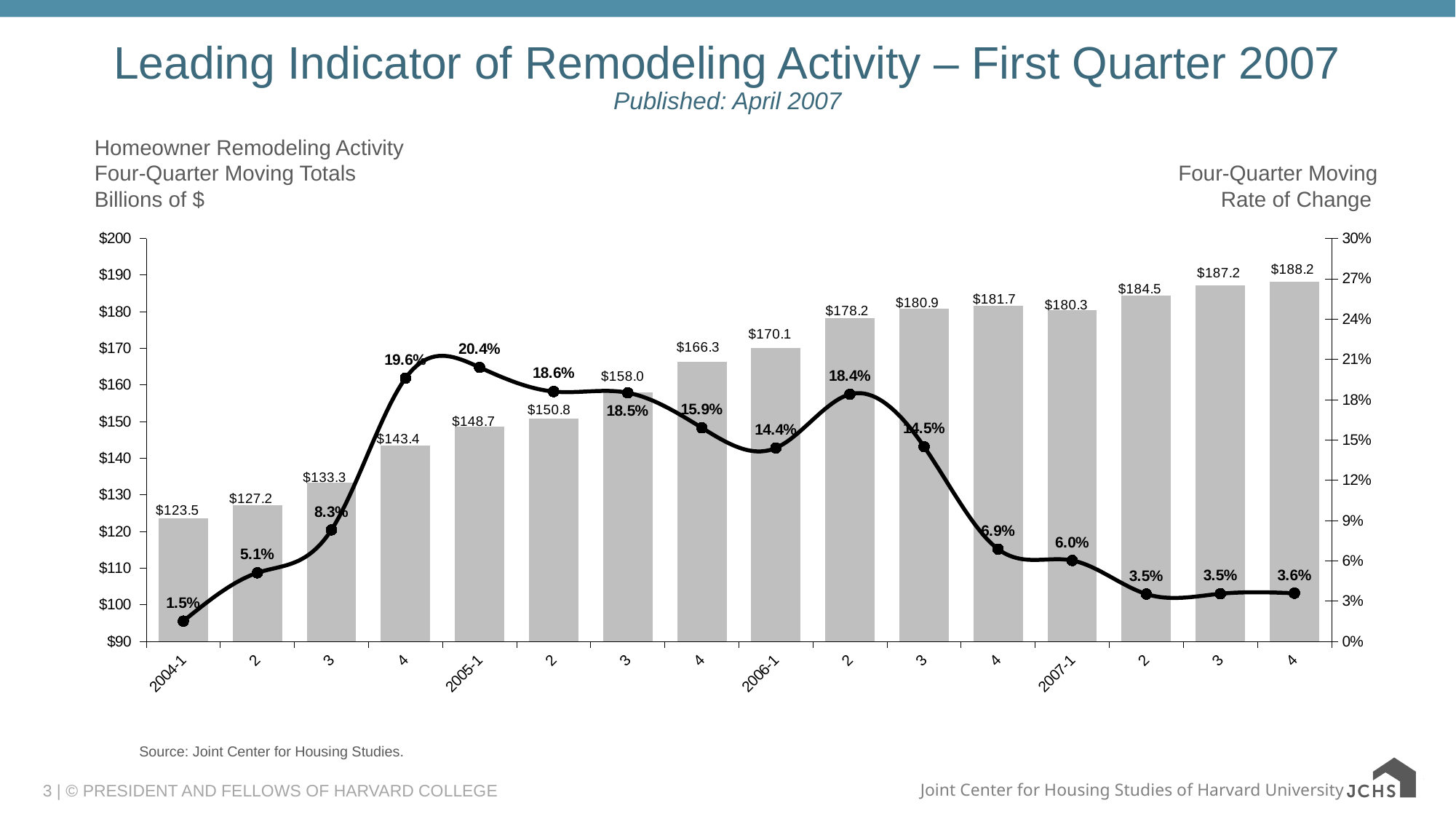
What kind of chart is used to show the four-quarter moving totals? bar chart Do the four-quarter moving totals generally rise or fall from 2004-1 to 2007-4? rise What is the difference between the four-quarter moving totals for 2007-4 and 2004-1? $64.7 Which quarter has the lowest four-quarter moving rate of change? 2004-1 What is the four-quarter moving rate of change for 2005-1? 20.4% What is the four-quarter moving total for 2007-1? $180.3 Is the four-quarter moving total for 2005-3 greater or less than $150? greater Which is larger, the four-quarter moving total for 2006-4 or for 2007-1? 2006-4 What is the unit of the left axis, as stated above the chart? Billions of $ Which quarter has the highest four-quarter moving total? 2007-4 What is the four-quarter moving total for 2004-1? $123.5 How many quarters are shown on the x axis? 16